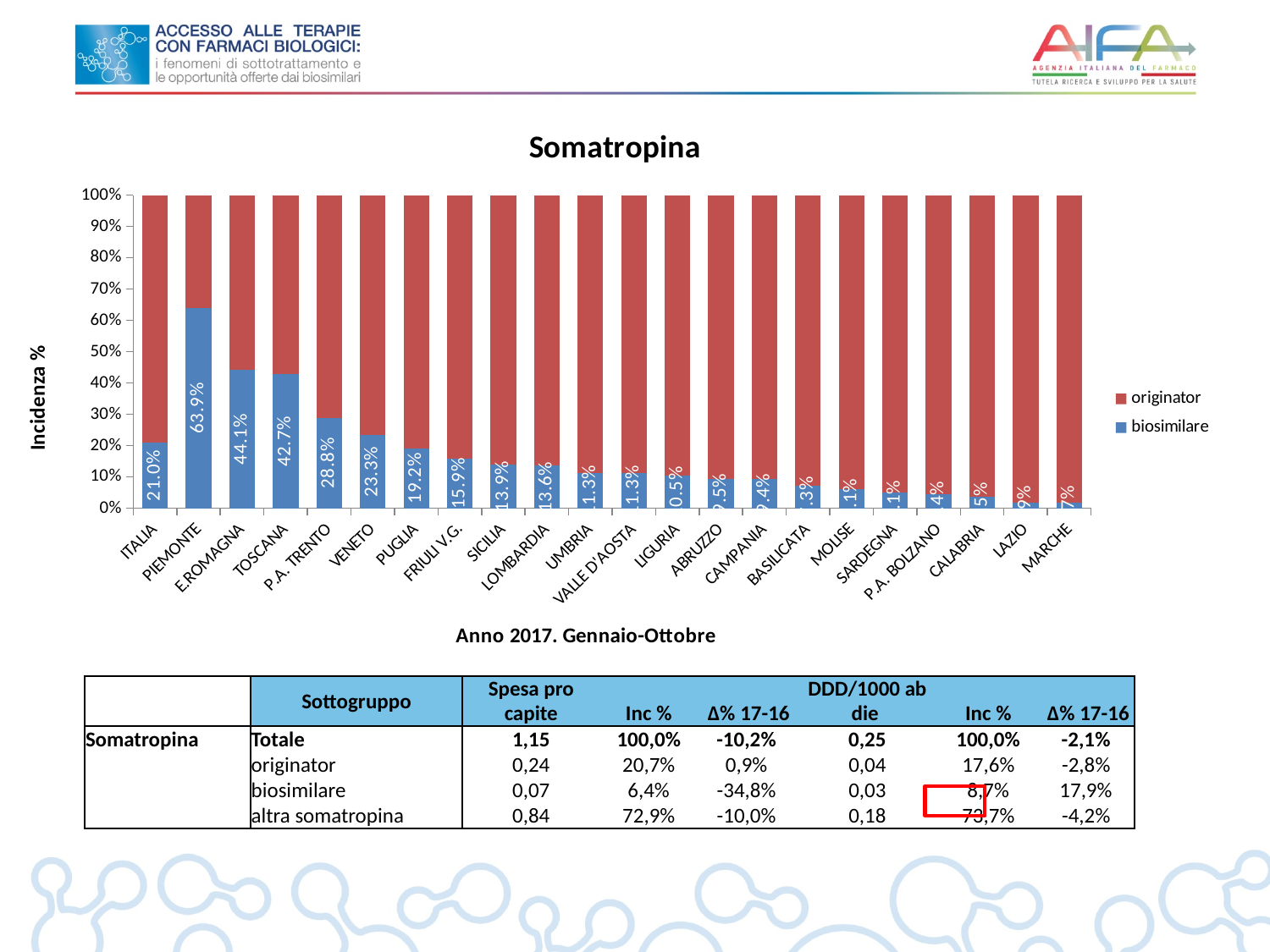
Does the biosimilare share rise or fall moving from PIEMONTE to MARCHE along the x axis? fall Which region has the highest biosimilare share? PIEMONTE What is the biosimilare share for ITALIA? 21.0% Which has a larger biosimilare share, P.A. TRENTO or PUGLIA? P.A. TRENTO What kind of chart is shown on the slide? stacked bar chart What is the biosimilare share for PIEMONTE? 63.9% How many regions (categories) are shown on the x axis? 22 What is the difference in biosimilare share between PIEMONTE and E.ROMAGNA? 19.8 percentage points What is the biosimilare share for VENETO? 23.3% How many series does the legend list? 2 What is the biosimilare share for TOSCANA? 42.7% Is the originator share for PIEMONTE greater or less than 40%? less